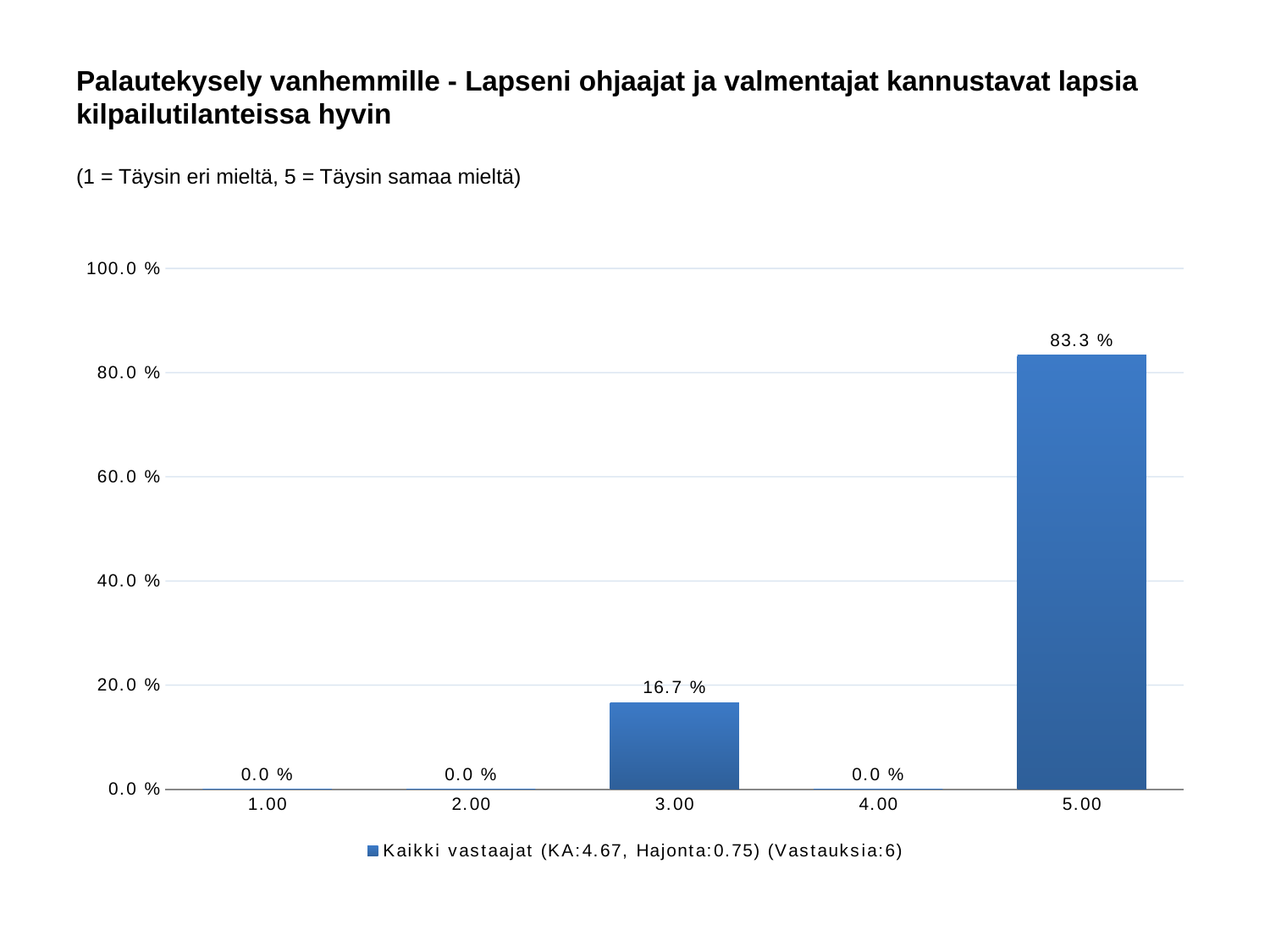
Which category has the highest value? 5.00 What kind of chart is shown? bar chart How many categories have a value of 0.0 %? 3 What is the value for category 5.00? 83.3 % How many series does the legend list? 1 How many categories are shown on the x axis? 5 What is the value for category 1.00? 0.0 % What is the difference between the values for 5.00 and 3.00? 66.6 % What is the number of responses (Vastauksia) given in the legend? 6 Is the value for 5.00 greater or less than 80.0 %? greater Which is larger, the value for 3.00 or the value for 4.00? 3.00 What is the value for category 3.00? 16.7 %